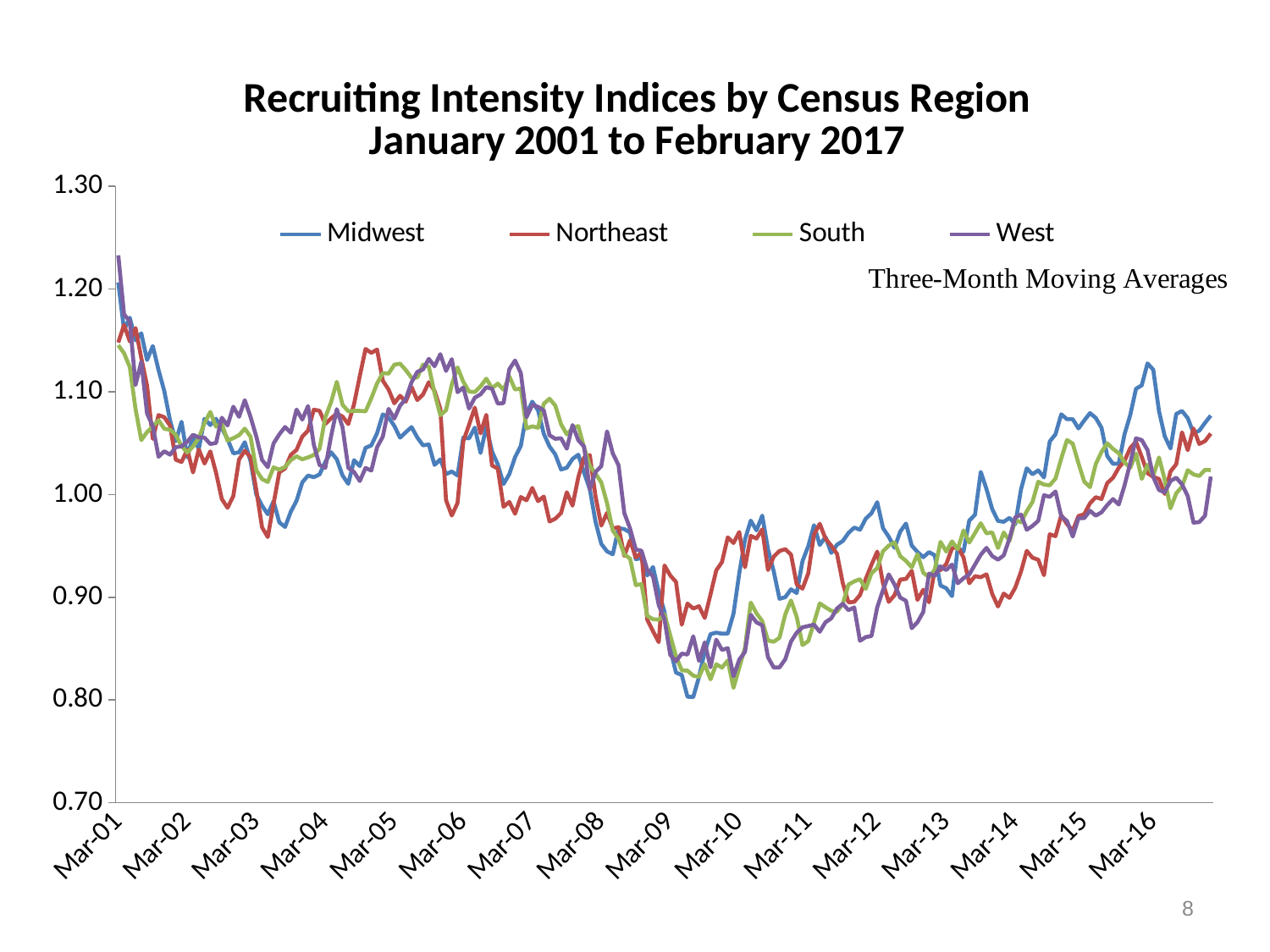
What is the title of the chart? Recruiting Intensity Indices by Census Region January 2001 to February 2017 What are the four series named in the legend? Midwest, Northeast, South, West How many series does the legend list? 4 Is the value for Midwest at Mar-01 greater or less than 1.10? greater Is the value for South at Mar-10 greater or less than 0.90? less How many year labels are shown on the x axis? 16 Is the peak of the Midwest series near Mar-16 greater or less than 1.10? greater Do the series generally rise or fall between Mar-08 and Mar-09? fall What kind of chart is shown on the slide? line chart Around Mar-16, which series is higher, Midwest or West? Midwest